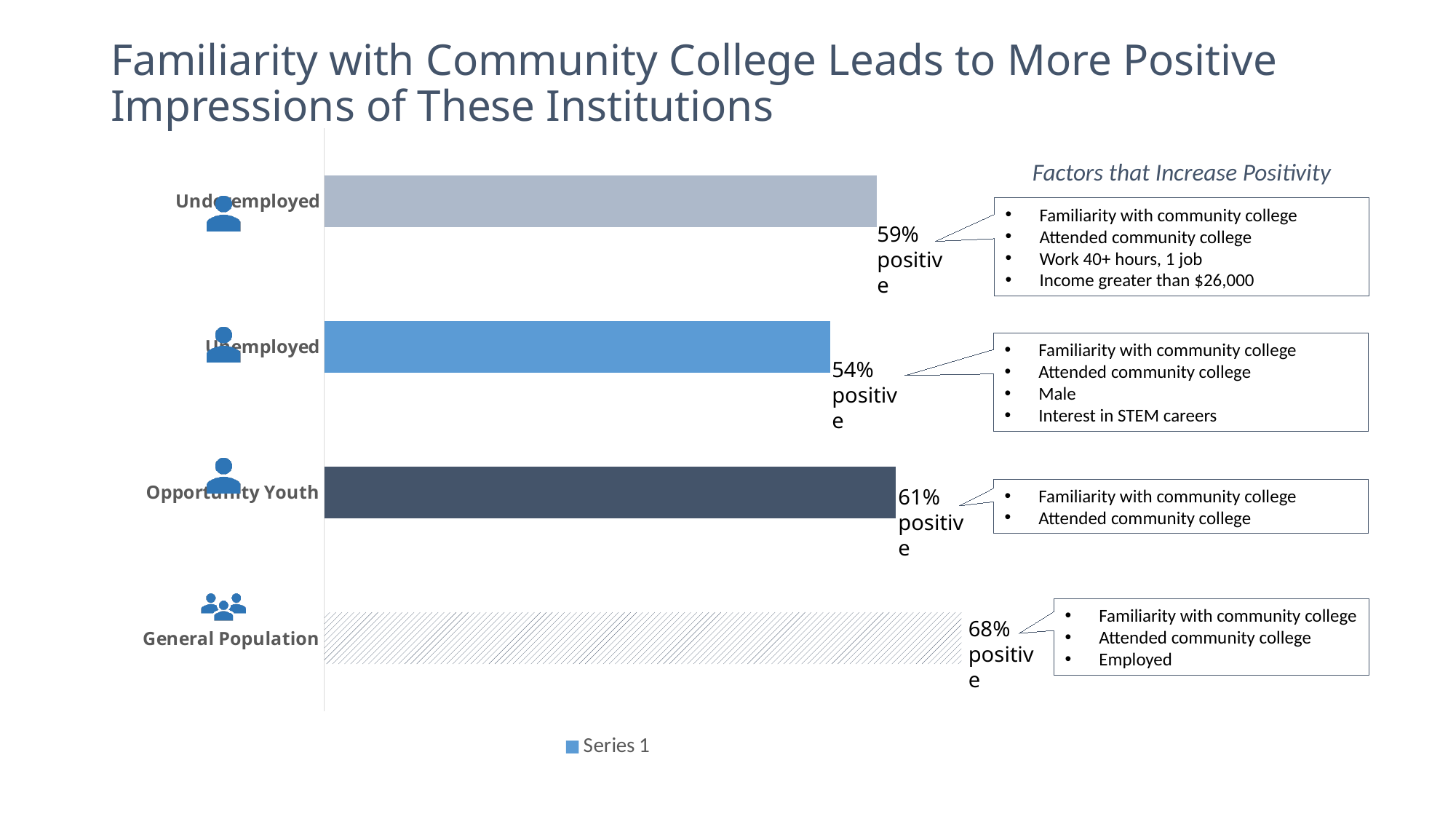
What is the difference in positive impressions between the General Population and the Unemployed group? 14% How many groups are shown in the bar chart? 4 What kind of chart is shown on the slide? bar chart Which group has the highest share of positive impressions? General Population What percentage of Opportunity Youth has a positive impression? 61% What series name does the legend show? Series 1 Which group has a higher share of positive impressions, Underemployed or Unemployed? Underemployed Which group has the lowest share of positive impressions? Unemployed What percentage of the Unemployed group has a positive impression? 54% What is the difference in positive impressions between Opportunity Youth and the Underemployed group? 2% What percentage of the Underemployed group has a positive impression of community college? 59% What percentage of the General Population has a positive impression? 68%